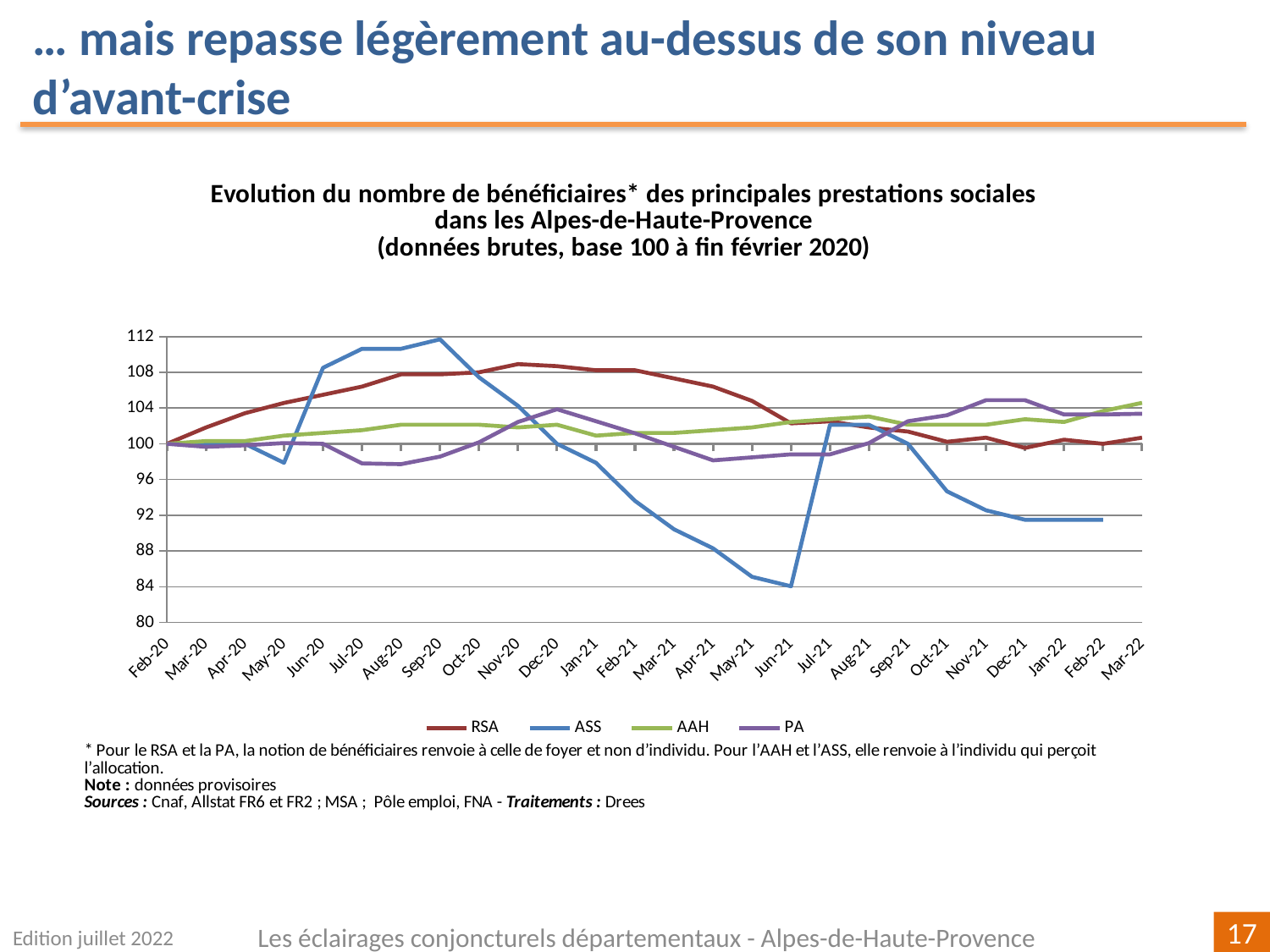
Is the value for ASS at Sep-20 greater or less than 108? greater At Jun-21, which is larger: the RSA value or the ASS value? RSA Does the ASS series rise or fall between Sep-20 and Jun-21? Fall How many monthly points are shown along the x axis, from Feb-20 to Mar-22? 26 Is the value for ASS at Jun-21 greater or less than 88? less Which series reaches the highest value on the chart? ASS Which colour is used for the ASS series in the legend? Blue Which series reaches the lowest value on the chart? ASS Is the value for PA at Jul-20 greater or less than 100? less What kind of chart is shown on the slide? Line chart What is the value of the RSA series at Feb-20, the base month? 100 How many series does the legend list? 4